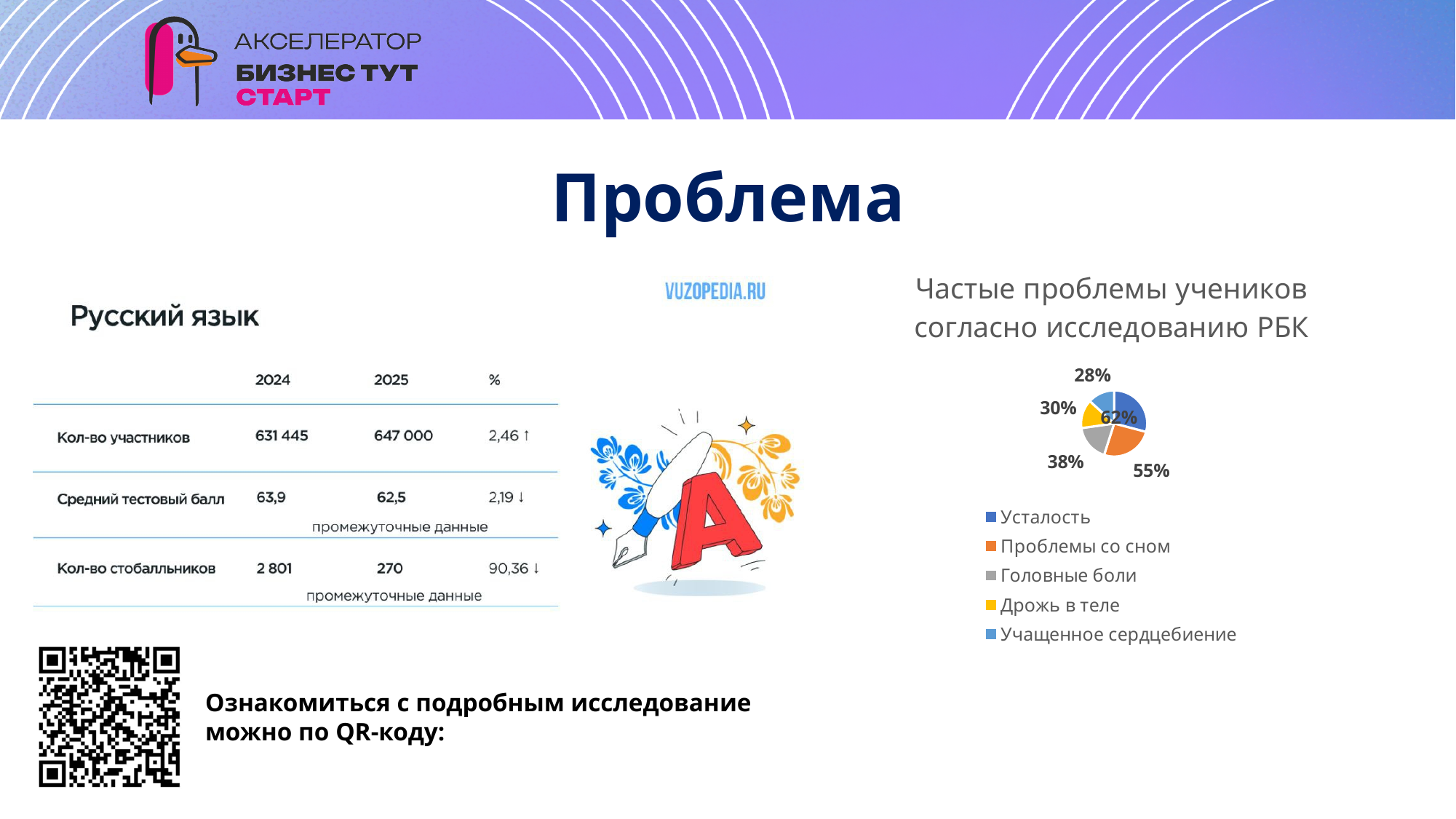
In the pie chart, what value is shown for "Учащенное сердцебиение"? 28% In the pie chart, what value is shown for "Усталость"? 62% What colour is the "Дрожь в теле" slice in the pie chart? yellow In the pie chart, what value is shown for "Головные боли"? 38% Which category has the smallest slice in the pie chart? Учащенное сердцебиение In the pie chart, what is the difference between the values for "Усталость" and "Проблемы со сном"? 7% In the pie chart, what value is shown for "Проблемы со сном"? 55% What kind of chart is shown under the title "Частые проблемы учеников согласно исследованию РБК"? pie chart How many categories does the pie chart's legend list? 5 In the pie chart, what value is shown for "Дрожь в теле"? 30% Which category has the largest slice in the pie chart? Усталость In the pie chart, which is larger: "Головные боли" or "Дрожь в теле"? Головные боли